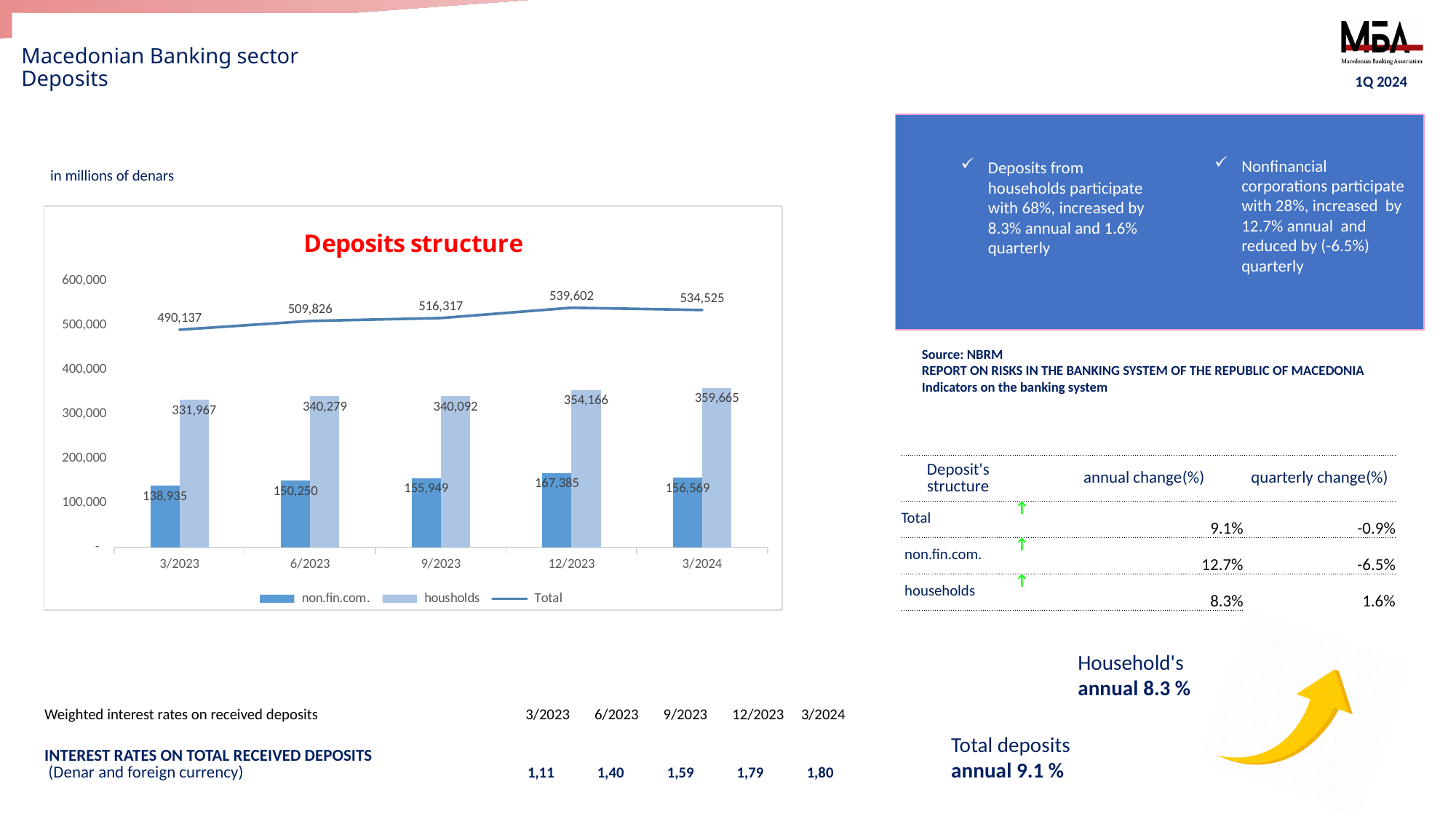
What is the housholds value for 3/2024 in the Deposits structure chart? 359,665 What unit is stated above the Deposits structure chart? in millions of denars How many periods are shown on the x axis of the Deposits structure chart? 5 What is the difference between the housholds value and the non.fin.com. value for 3/2024 in the Deposits structure chart? 203,096 How many series does the legend of the Deposits structure chart list? 3 In which period is the non.fin.com. value lowest in the Deposits structure chart? 3/2023 What is the non.fin.com. value for 6/2023 in the Deposits structure chart? 150,250 Does the housholds series rise or fall from 3/2023 to 3/2024 in the Deposits structure chart? Rise In which period does the Total line reach its highest value in the Deposits structure chart? 12/2023 What kind of chart is the Deposits structure chart? Combined bar and line chart What is the value of the Total line for 12/2023 in the Deposits structure chart? 539,602 Which is larger in the Deposits structure chart: the non.fin.com. value for 12/2023 or for 3/2024? 12/2023